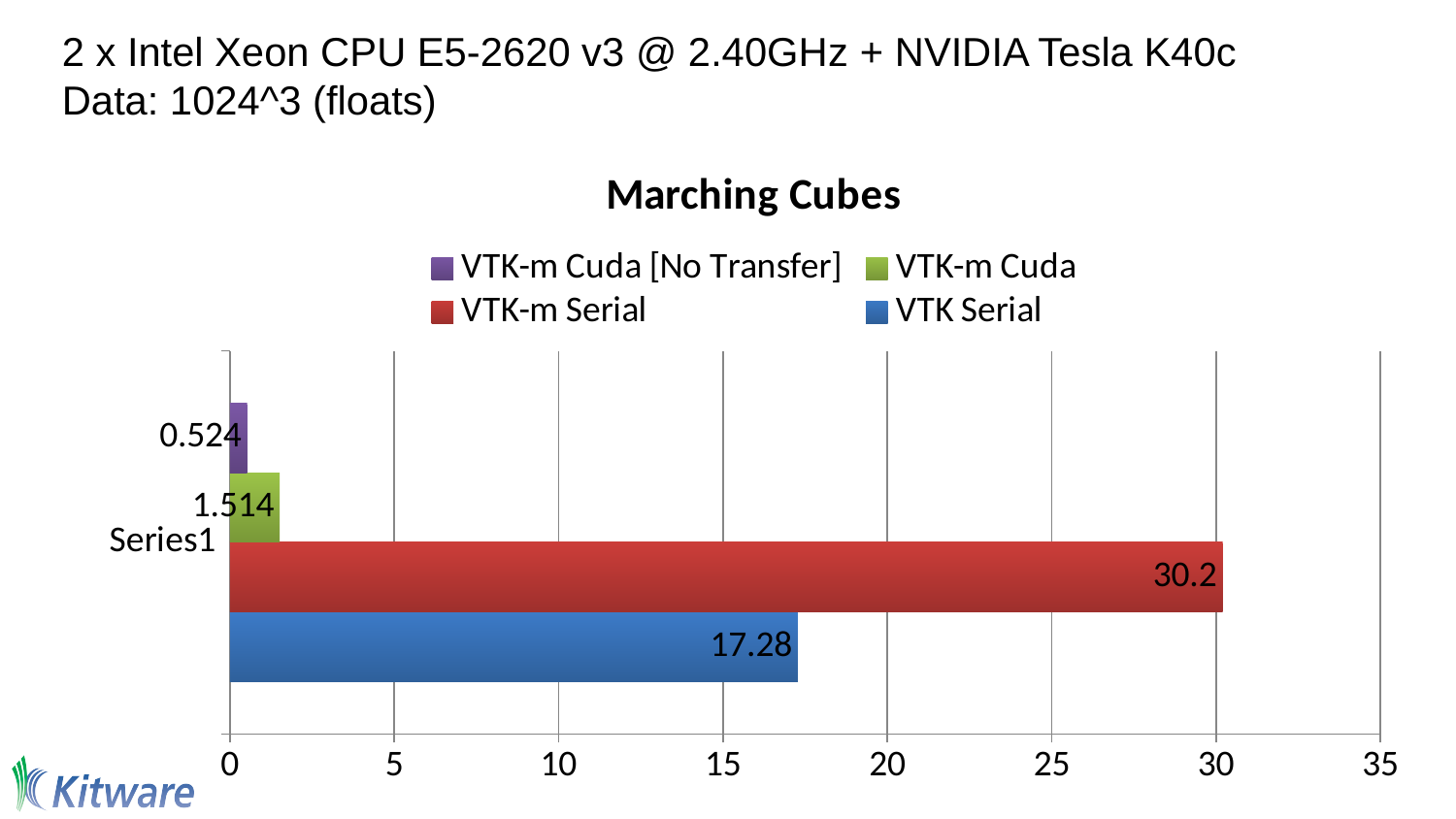
Which series has the highest value? VTK-m Serial How many series does the legend list? 4 Is the value for VTK Serial greater or less than 15? greater What is the value for VTK-m Cuda? 1.514 Which is larger, the value for VTK-m Cuda or the value for VTK-m Cuda [No Transfer]? VTK-m Cuda What kind of chart is shown? bar chart What is the difference between the VTK-m Serial and VTK Serial values? 12.92 What is the value for VTK-m Serial? 30.2 What is the value for VTK-m Cuda [No Transfer]? 0.524 Which series has the lowest value? VTK-m Cuda [No Transfer] What is the value for VTK Serial? 17.28 What is the title of the chart? Marching Cubes